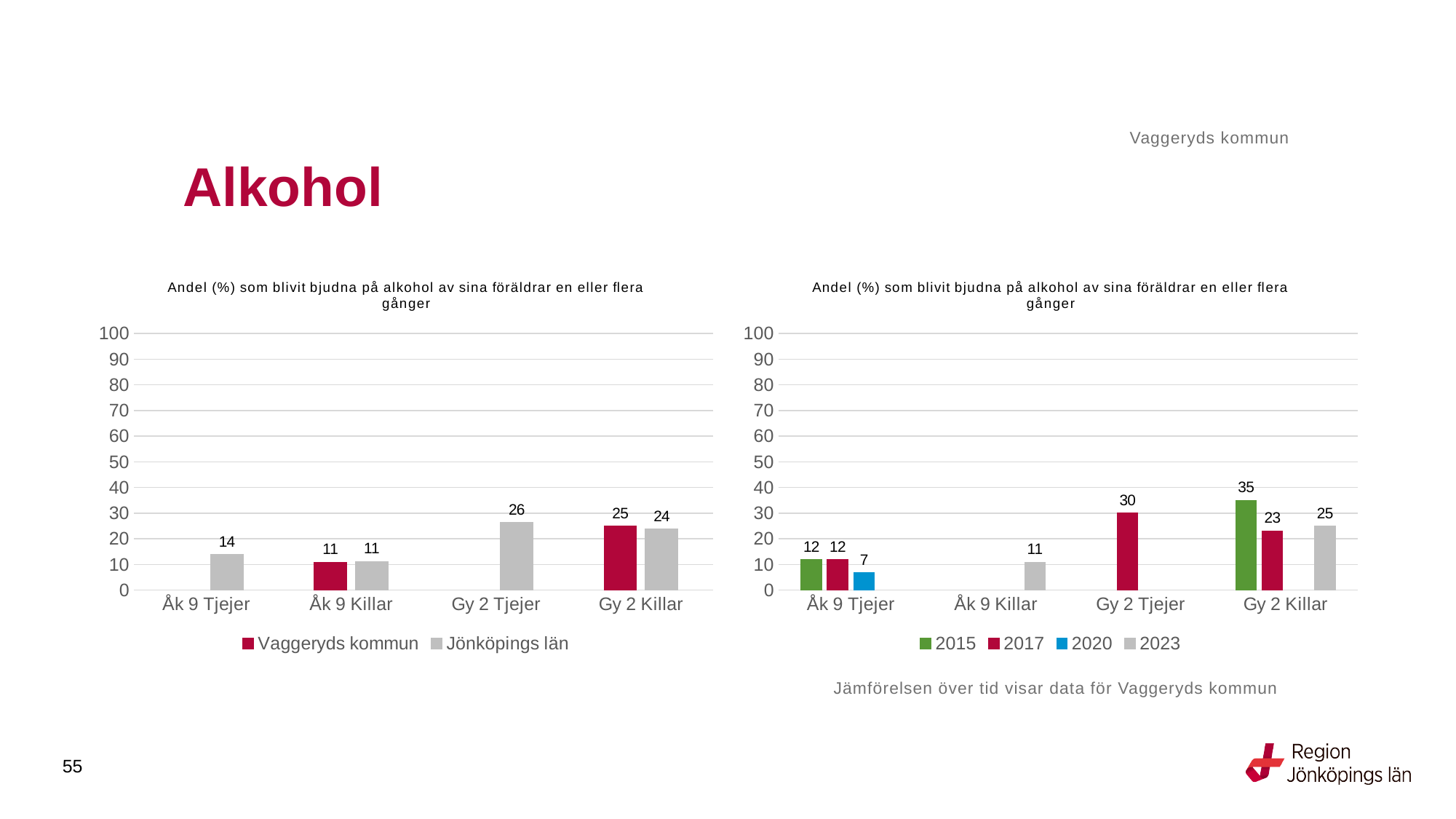
In the right chart, what is the value for 2017 for Gy 2 Tjejer? 30 In the right chart, is the 2023 value for Gy 2 Killar larger or smaller than the 2017 value for Gy 2 Killar? larger In the right chart, how many series does the legend list? 4 In the right chart, what is the difference between the 2015 and 2017 values for Gy 2 Killar? 12 In the left chart, what is the value for Vaggeryds kommun for Gy 2 Killar? 25 In the left chart, which category has the lowest value for Jönköpings län? Åk 9 Killar What type of chart is the right chart? bar chart In the left chart, how many series does the legend list? 2 In the right chart, what is the value for 2020 for Åk 9 Tjejer? 7 In the right chart, which year has the highest value for Gy 2 Killar? 2015 In the left chart, what is the value for Jönköpings län for Gy 2 Tjejer? 26 In the left chart, what is the difference between Vaggeryds kommun and Jönköpings län for Gy 2 Killar? 1